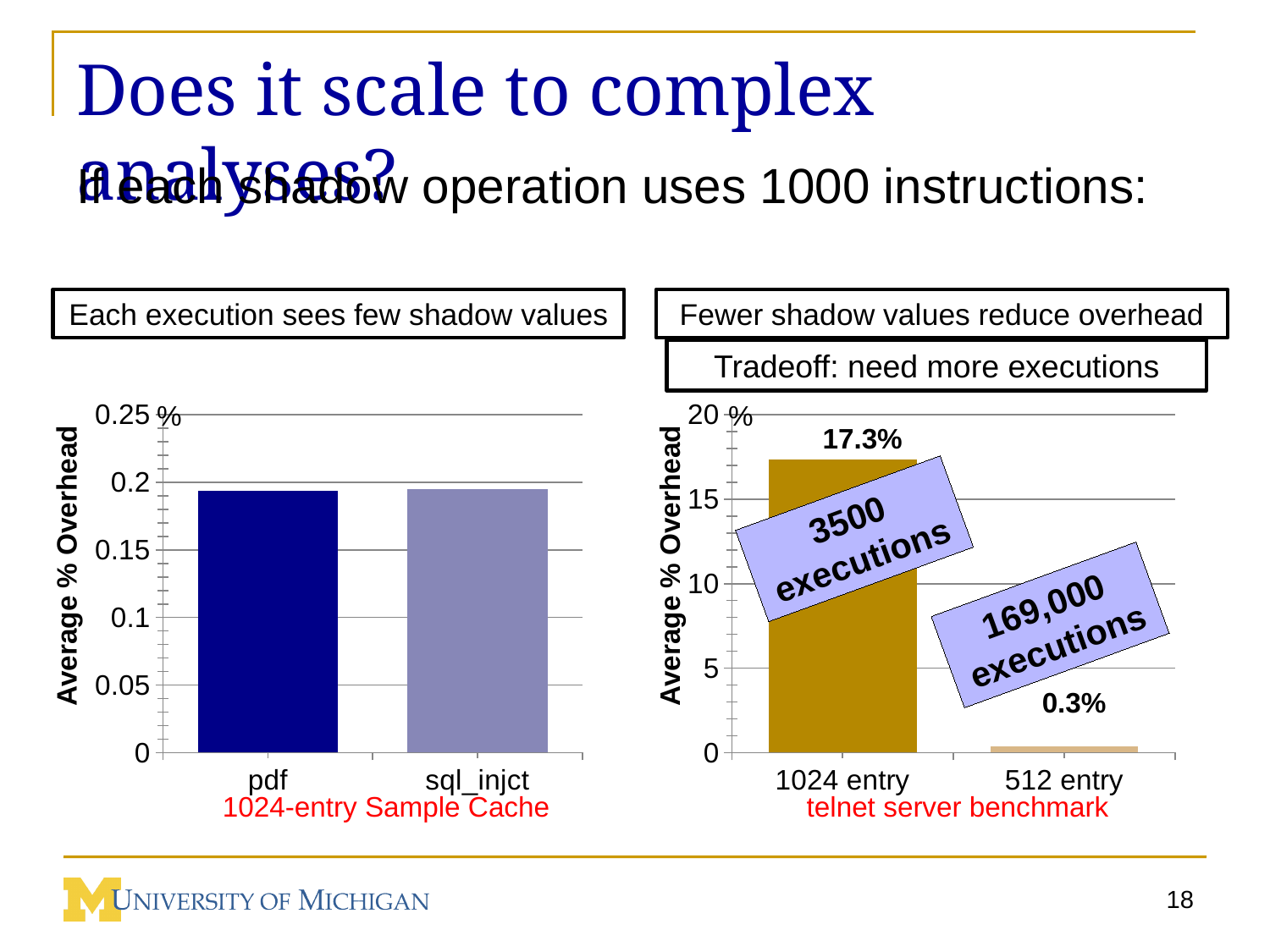
In the telnet server benchmark chart, which configuration has the higher average % overhead? 1024 entry What kind of chart is the telnet server benchmark chart? bar chart In the telnet server benchmark chart, what is the difference in average % overhead between the 1024 entry and 512 entry configurations? 17.0% How many categories are shown in the 1024-entry Sample Cache chart? 2 In the 1024-entry Sample Cache chart, is the value for sql_injct greater or less than 0.1? greater In the telnet server benchmark chart, is the value for 1024 entry greater or less than 15? greater In the telnet server benchmark chart, what is the average % overhead for the 512 entry configuration? 0.3% What is the y-axis label of the 1024-entry Sample Cache chart? Average % Overhead In the telnet server benchmark chart, how many executions are annotated for the 512 entry configuration? 169,000 executions In the telnet server benchmark chart, which configuration has the lowest average % overhead? 512 entry In the telnet server benchmark chart, what is the average % overhead for the 1024 entry configuration? 17.3% In the 1024-entry Sample Cache chart, is the value for pdf greater or less than 0.15? greater